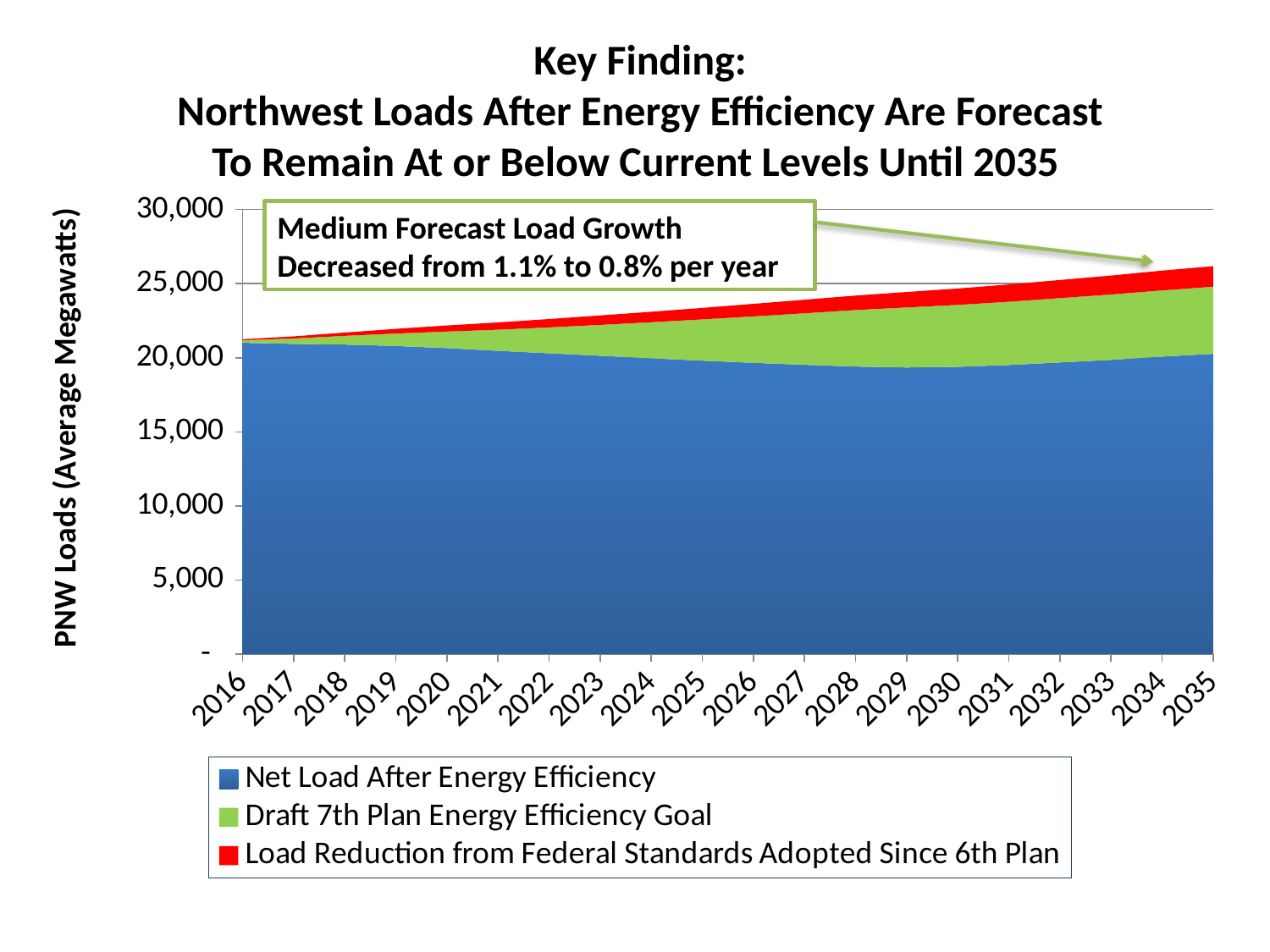
What is the first year shown on the x axis? 2016 Is the total of all three stacked series in 2035 greater or less than 25,000? greater What kind of chart is shown on the slide? Stacked area chart Is the value for Net Load After Energy Efficiency in 2016 greater or less than 20,000? greater How many years are shown along the x axis? 20 Is the value for Net Load After Energy Efficiency in 2028 greater or less than 20,000? less According to the text box on the chart, medium forecast load growth decreased from what rate to what rate per year? From 1.1% to 0.8% per year What is the label on the y axis? PNW Loads (Average Megawatts) How many series does the legend list? 3 What is the last year shown on the x axis? 2035 Does the total of the stacked series rise or fall from 2016 to 2035? rise